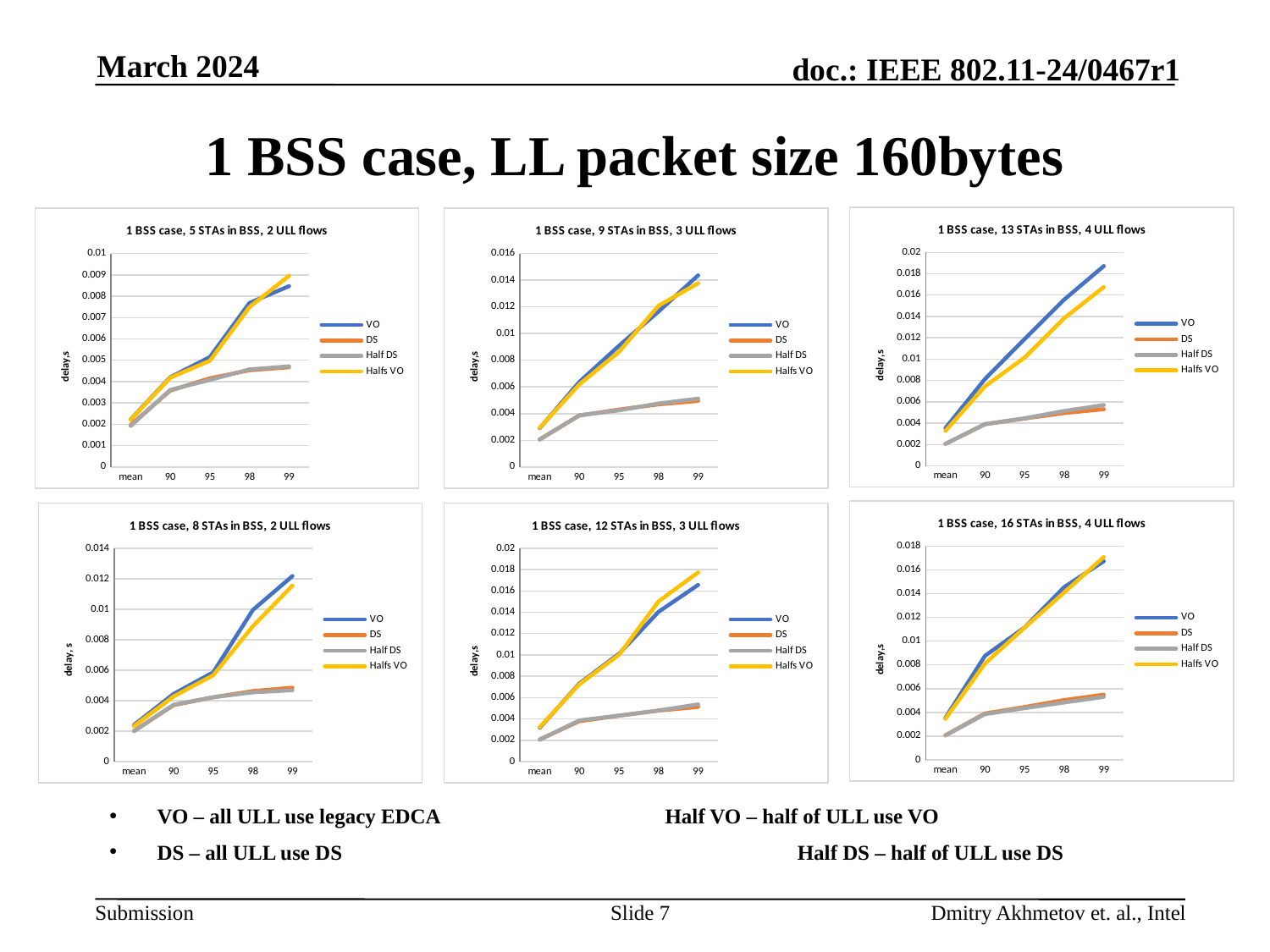
In "1 BSS case, 8 STAs in BSS, 2 ULL flows", is the VO value at 99 greater or less than 0.01? greater In "1 BSS case, 9 STAs in BSS, 3 ULL flows", is the Half DS value at 99 greater or less than 0.006? less What is the y-axis label of "1 BSS case, 8 STAs in BSS, 2 ULL flows"? delay, s In "1 BSS case, 5 STAs in BSS, 2 ULL flows", does the VO series rise or fall from mean to 99? rise In "1 BSS case, 16 STAs in BSS, 4 ULL flows", is the VO value at 99 greater or less than 0.014? greater In "1 BSS case, 13 STAs in BSS, 4 ULL flows", which is larger at 99, VO or Halfs VO? VO How many points are on the x axis of "1 BSS case, 13 STAs in BSS, 4 ULL flows"? 5 How many series does the legend of "1 BSS case, 9 STAs in BSS, 3 ULL flows" list? 4 In "1 BSS case, 12 STAs in BSS, 3 ULL flows", which series has the highest value at 99? Halfs VO What kind of chart is "1 BSS case, 5 STAs in BSS, 2 ULL flows"? line chart